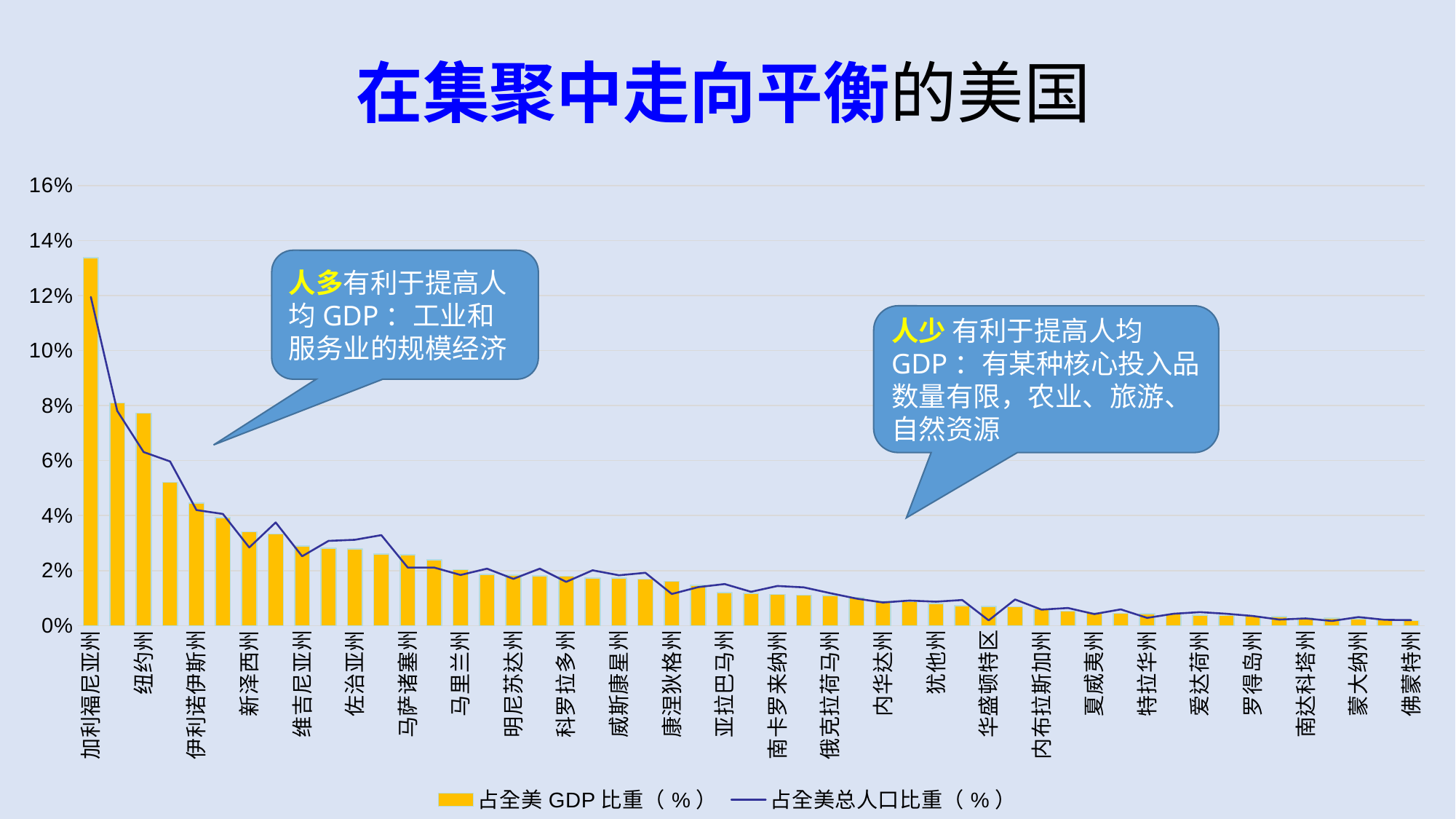
How many series does the legend list? 2 Which state has the highest share of US GDP (占全美 GDP 比重)? 加利福尼亚州 Which has a larger GDP share (占全美 GDP 比重), 新泽西州 or 佐治亚州? 新泽西州 What are the two series named in the legend? 占全美 GDP 比重（%） and 占全美总人口比重（%） Is the GDP share (占全美 GDP 比重) for 加利福尼亚州 greater or less than 12%? greater Which has a larger GDP share (占全美 GDP 比重), 加利福尼亚州 or 纽约州? 加利福尼亚州 Is the GDP share (占全美 GDP 比重) for 纽约州 greater or less than 6%? greater Is the population share (占全美总人口比重) for 加利福尼亚州 greater or less than 10%? greater What kind of chart is shown on the slide? A bar chart combined with a line chart Do the GDP share values rise or fall moving from left to right along the x axis? fall Which labelled state has the lowest share of US GDP (占全美 GDP 比重)? 佛蒙特州